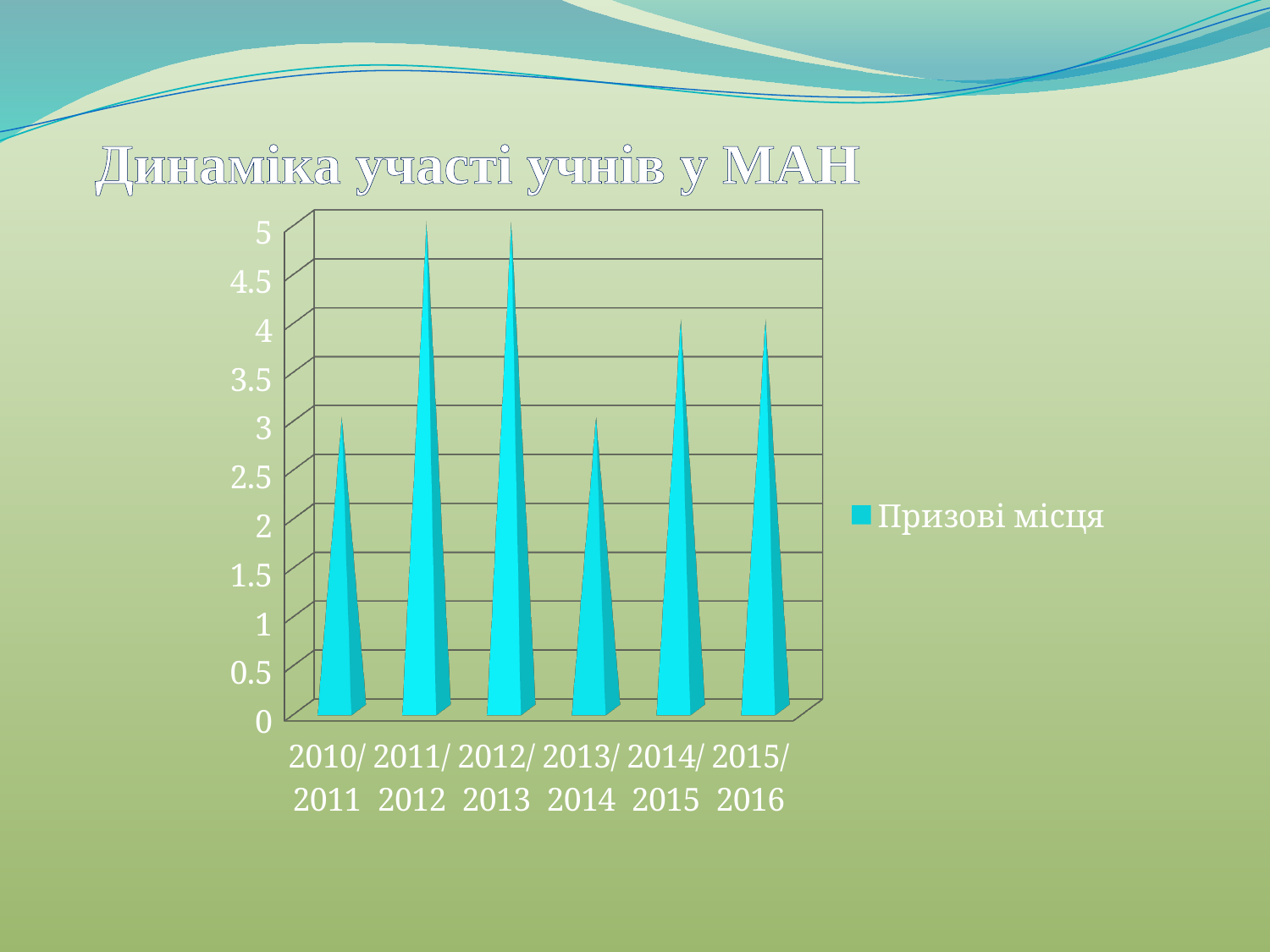
What is the value for 2011/2012? 5 What kind of chart is shown on the slide? bar chart Which is larger, the value for 2012/2013 or the value for 2013/2014? 2012/2013 Is the value for 2014/2015 greater or less than 3.5? greater What is the name of the series shown in the legend? Призові місця How many series does the legend list? 1 Is the value for 2010/2011 greater or less than 4? less How many categories (school years) are shown on the x axis? 6 What is the value for 2015/2016? 4 What is the difference between the value for 2011/2012 and the value for 2010/2011? 2 What is the value for 2013/2014? 3 What is the title of the chart? Динаміка участі учнів у МАН